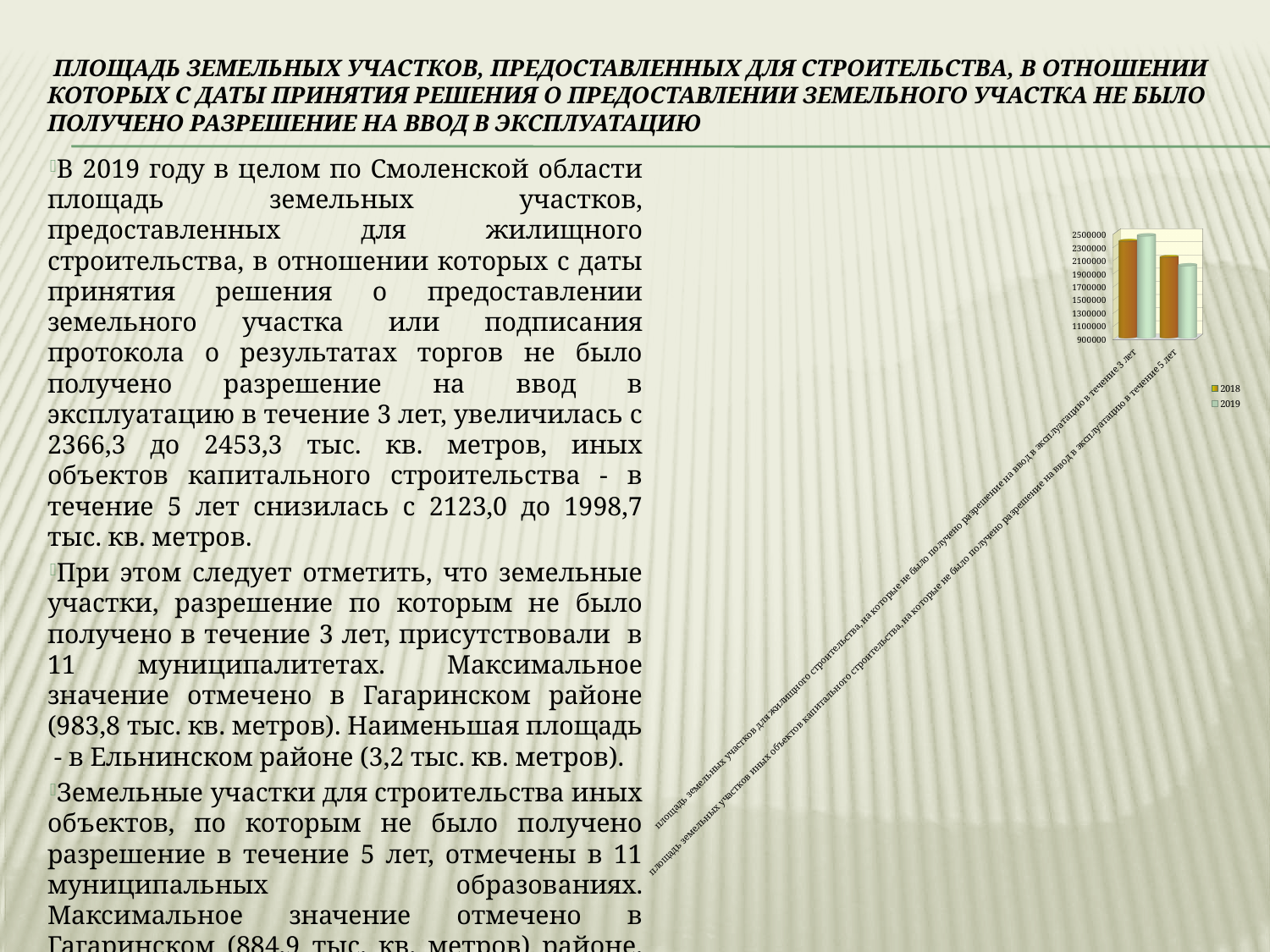
Do the 2019 values rise or fall from the left category to the right category? fall Is the 2019 value for the left category (housing construction, 3 years) greater or less than 2300000? greater How many categories are plotted on the chart's x axis? 2 Is the 2019 value for the right category (other capital construction objects, 5 years) greater or less than 2100000? less For the right category (land plots for other capital construction objects, 5 years), which series has the taller bar, 2018 or 2019? 2018 Is the 2018 value for the left category (housing construction, 3 years) greater or less than 2100000? greater For the left category (land plots for housing construction, 3 years), which series has the taller bar, 2018 or 2019? 2019 Which years are listed in the chart legend? 2018 and 2019 What kind of chart is shown on the right side of the slide? bar chart How many series does the chart legend list? 2 Which bar is the shortest on the chart? 2019, other capital construction objects (5 years) Which bar is the tallest on the chart? 2019, housing construction (3 years)